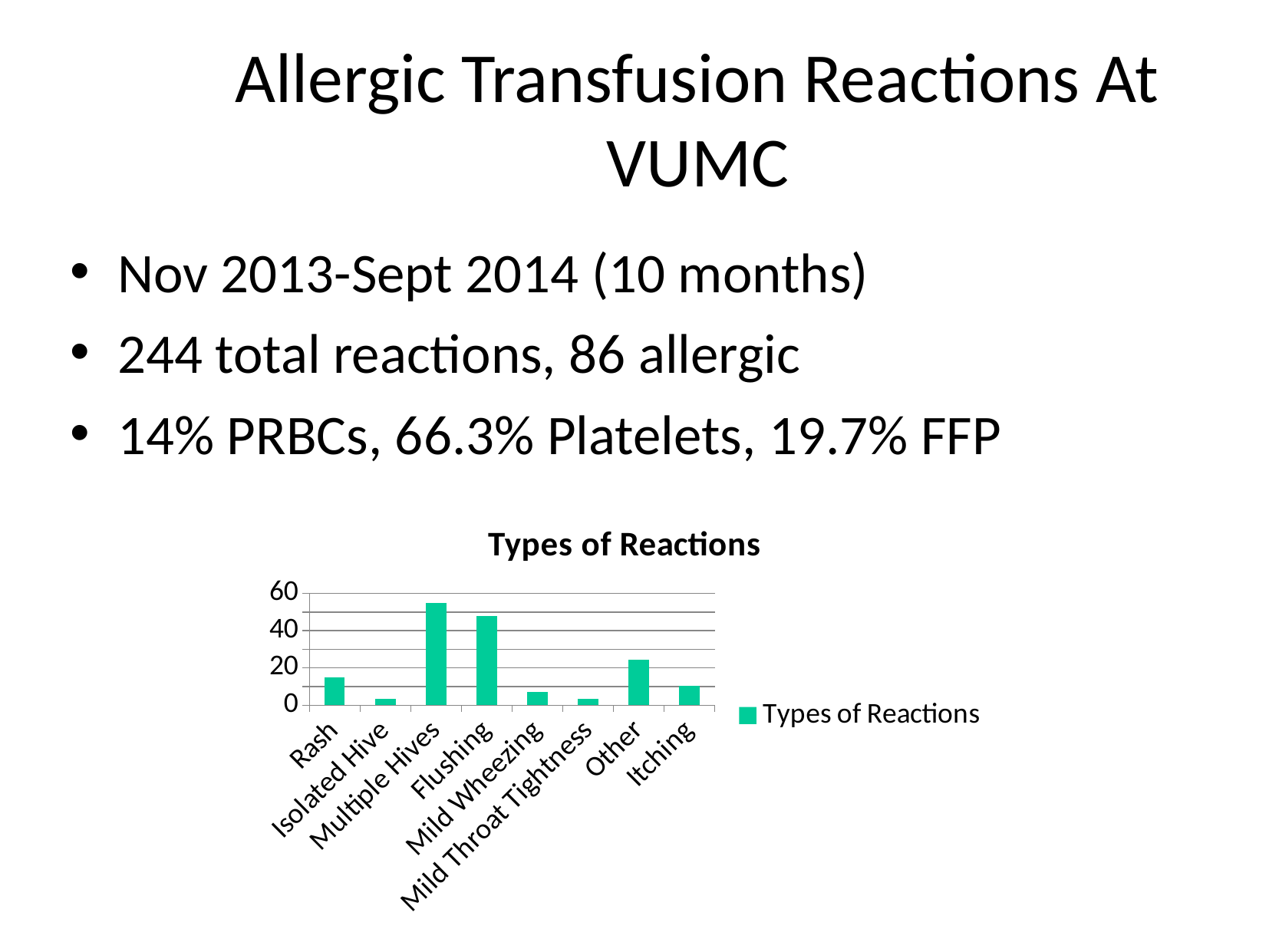
How many reaction categories are shown on the x axis of the chart? 8 Which is larger, the value for Other or the value for Rash? Other Which reaction type has the highest bar in the chart? Multiple Hives Is the value for Itching greater or less than 20? less Is the value for Rash greater or less than 20? less Is the value for Flushing greater or less than 40? greater What is the title of the chart? Types of Reactions Which is larger, the value for Flushing or the value for Mild Wheezing? Flushing How many series does the chart legend list? 1 What kind of chart is shown on the slide? bar chart